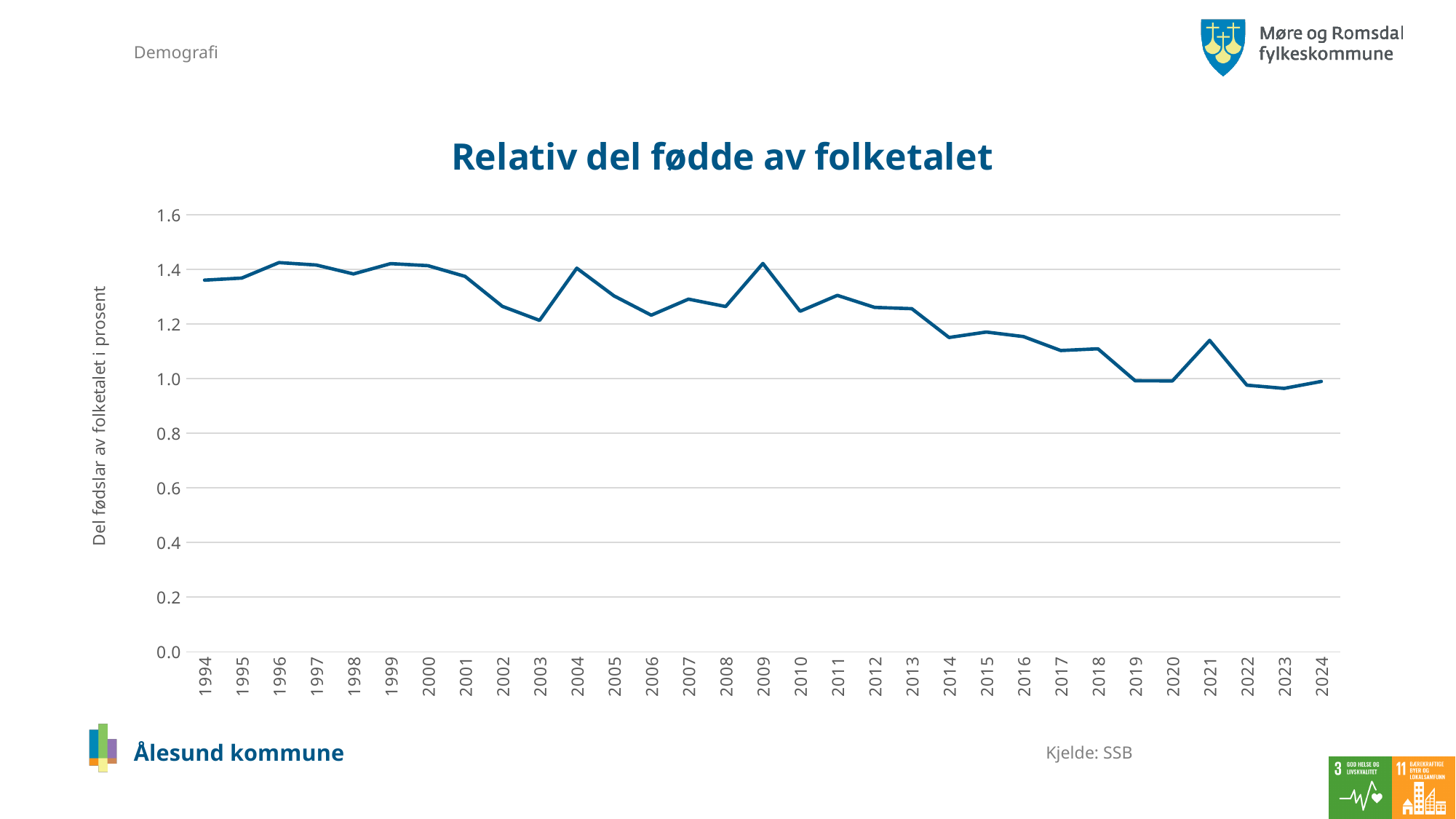
Is the value for 1994 greater or less than 1.2? greater Is the value for 2021 greater or less than 1.0? greater What is the label on the vertical axis of the chart? Del fødslar av folketalet i prosent Which year has the larger value, 2009 or 2010? 2009 Is the value for 2014 greater or less than 1.2? less What kind of chart is shown on the slide? line chart Which year has the larger value, 1994 or 2024? 1994 Overall, do the values rise or fall from 1994 to 2024? fall Which year has the larger value, 2020 or 2021? 2021 What is the title of the chart? Relativ del fødde av folketalet How many years are plotted along the x axis of the chart? 31